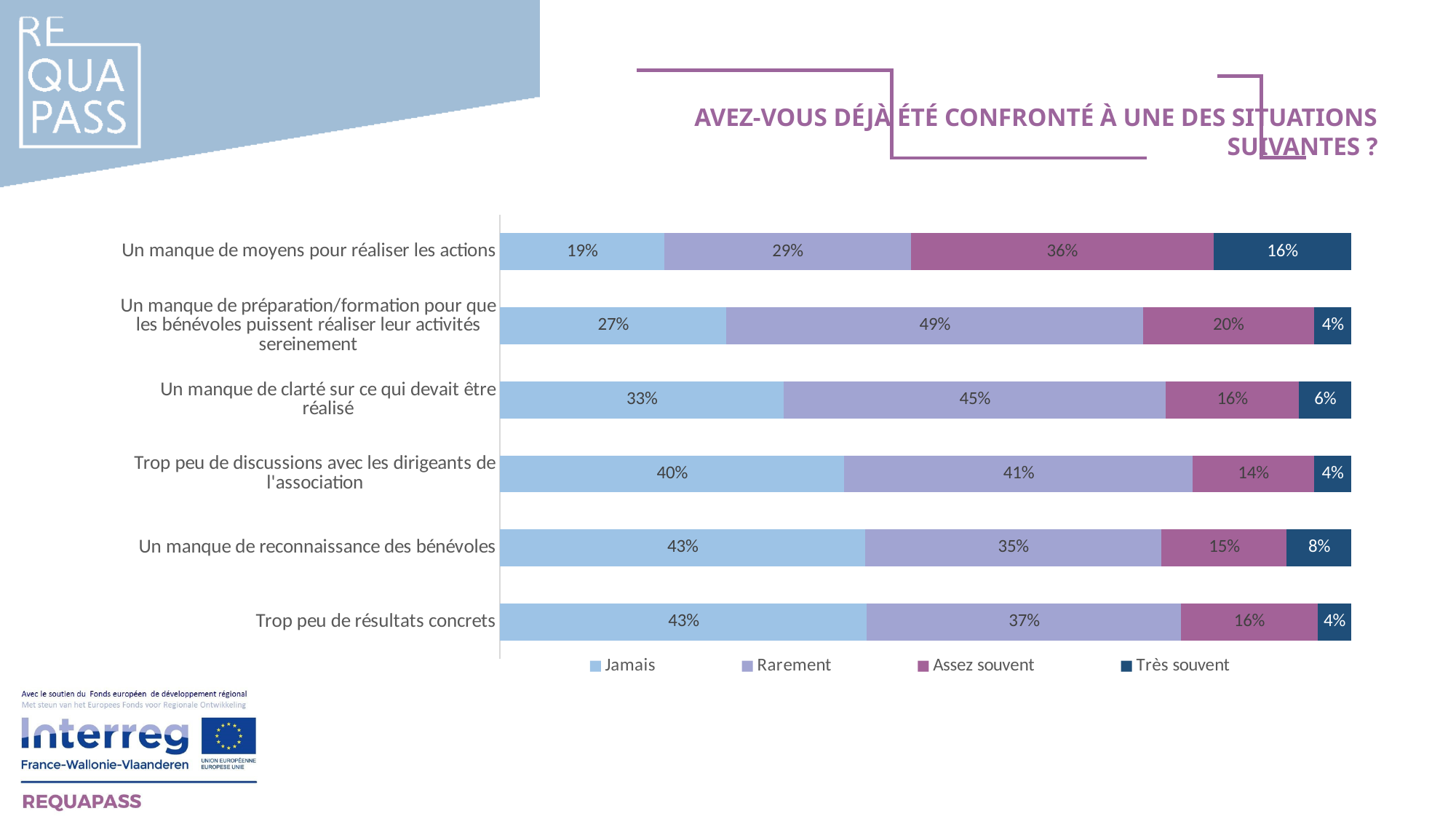
What is the total of the stacked bar for 'Un manque de moyens pour réaliser les actions'? 100% How many categories (situations) are shown in the chart? 6 Which category has the highest 'Assez souvent' value? Un manque de moyens pour réaliser les actions What kind of chart is shown on the slide? Stacked bar chart What is the 'Rarement' value for 'Un manque de préparation/formation pour que les bénévoles puissent réaliser leur activités sereinement'? 49% What is the value of the 'Jamais' segment for 'Un manque de moyens pour réaliser les actions'? 19% Which category has the lowest 'Jamais' value? Un manque de moyens pour réaliser les actions For 'Trop peu de résultats concrets', what is the difference between the 'Jamais' and 'Rarement' values? 6 percentage points How many series does the legend list? 4 Which has a larger 'Très souvent' value: 'Un manque de clarté sur ce qui devait être réalisé' or 'Trop peu de discussions avec les dirigeants de l'association'? Un manque de clarté sur ce qui devait être réalisé What is the 'Très souvent' value for 'Un manque de reconnaissance des bénévoles'? 8% What is the title of the chart? AVEZ-VOUS DÉJÀ ÉTÉ CONFRONTÉ À UNE DES SITUATIONS SUIVANTES ?